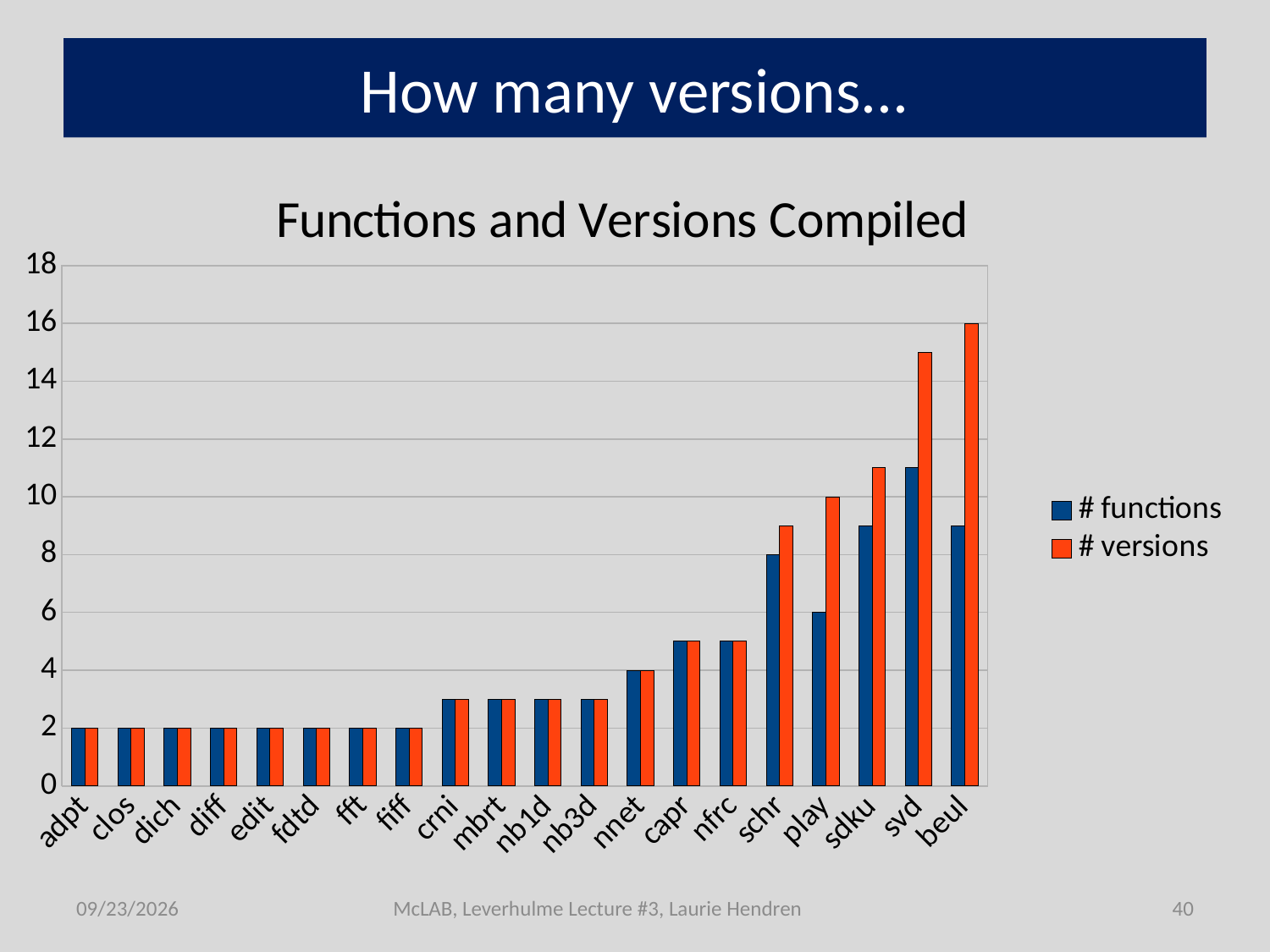
What is the # functions value for adpt? 2 Is the # versions value for svd greater or less than 14? greater What is the # functions value for schr? 8 What is the difference between the # versions for beul and the # versions for play? 6 Which category has the highest # versions? beul What kind of chart is shown on the slide? bar chart Which category has the highest # functions? svd How many series does the legend list? 2 How many categories are shown along the x axis? 20 What is the # versions value for beul? 16 Which has more # functions, svd or beul? svd What is the # versions value for play? 10